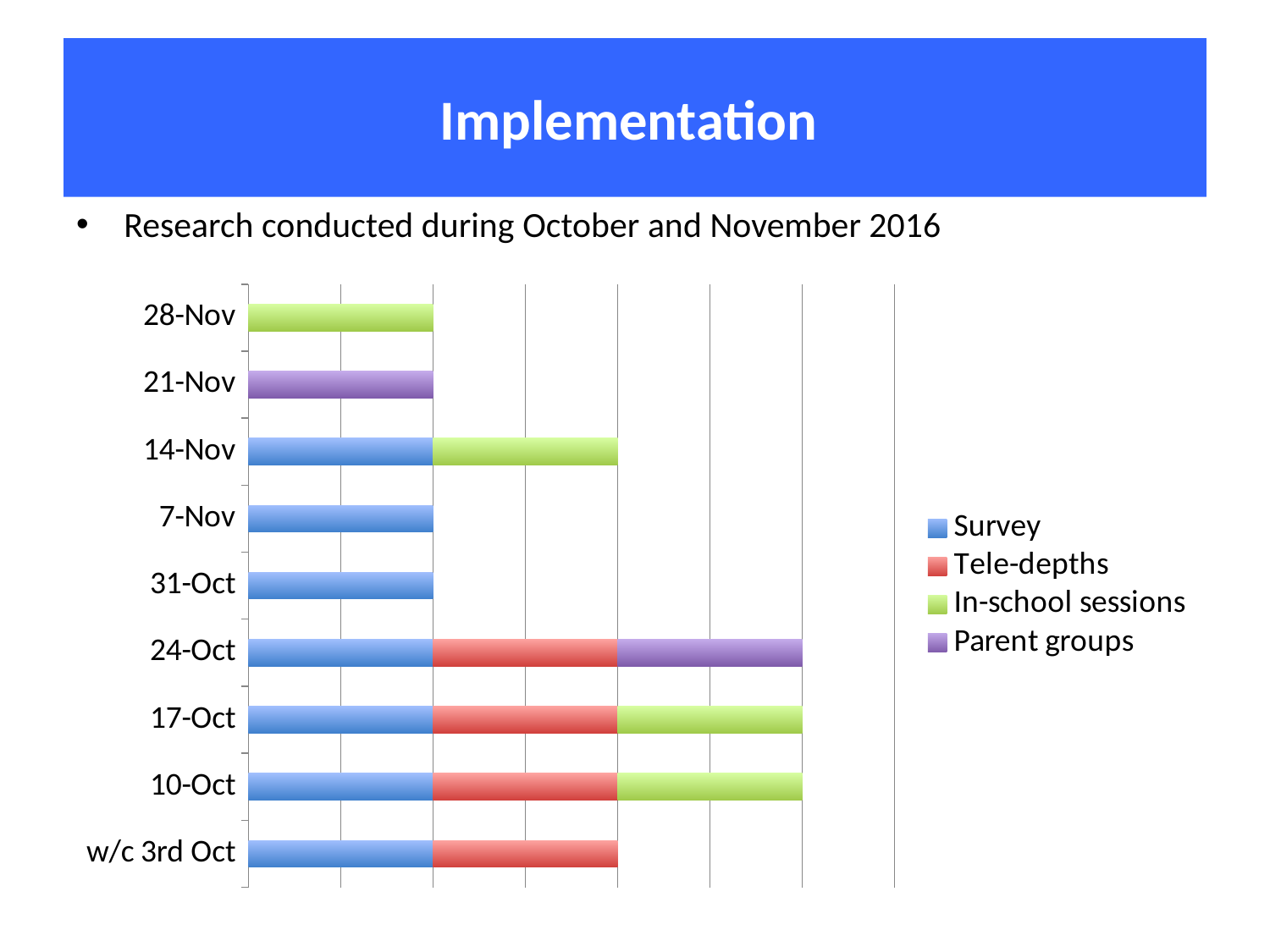
In how many weeks does the Parent groups series appear in the chart? 2 Which colour represents Tele-depths in the chart? Red How many series does the chart legend list? 4 In how many weeks does the Survey series appear in the chart? 7 Which bar is longer, the one for 14-Nov or the one for 7-Nov? 14-Nov Which series are listed in the chart legend? Survey, Tele-depths, In-school sessions, Parent groups How many weeks (categories) are listed on the vertical axis of the chart? 9 Which bar is longer, the one for 24-Oct or the one for 31-Oct? 24-Oct What kind of chart is shown on the slide? Stacked horizontal bar chart Which bar is longer, the one for 17-Oct or the one for w/c 3rd Oct? 17-Oct